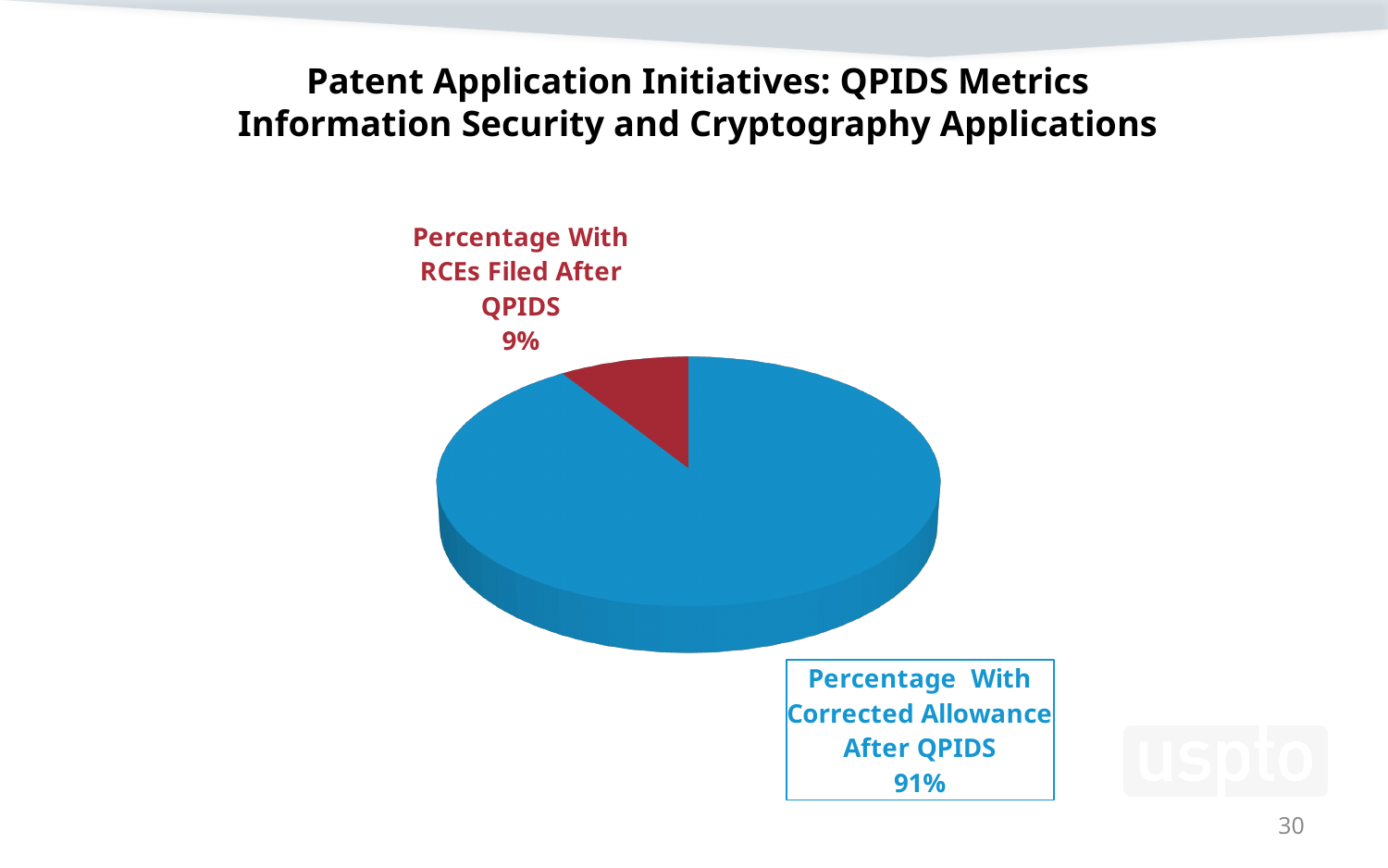
What kind of chart is shown on the slide? pie chart Which slice of the pie is the largest? Percentage With Corrected Allowance After QPIDS What colour is the slice for 'Percentage With Corrected Allowance After QPIDS'? blue Which is larger: the share with corrected allowance after QPIDS or the share with RCEs filed after QPIDS? Percentage With Corrected Allowance After QPIDS What percentage of applications had a corrected allowance after QPIDS? 91% What colour is the slice for 'Percentage With RCEs Filed After QPIDS'? red What is the total of the two slice percentages shown on the pie chart? 100% Which slice of the pie is the smallest? Percentage With RCEs Filed After QPIDS What is the difference in percentage points between the corrected allowance slice and the RCEs filed slice? 82 What share of the pie does the 'Percentage With RCEs Filed After QPIDS' slice represent? 9% What percentage of applications had RCEs filed after QPIDS? 9% How many slices does the pie chart have? 2